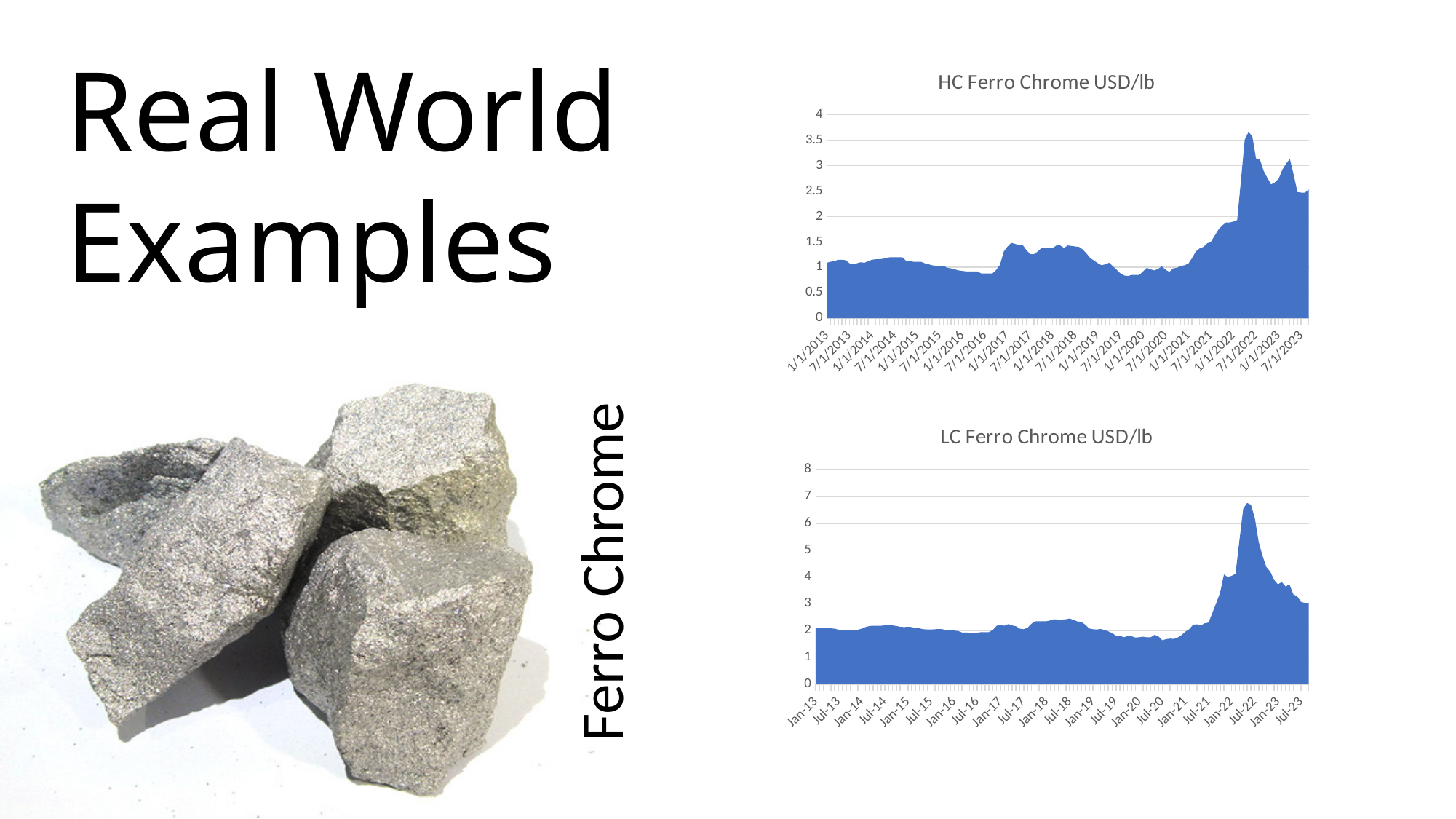
What is the title of the bottom chart on the slide? LC Ferro Chrome USD/lb What is the title of the top chart on the slide? HC Ferro Chrome USD/lb In which year does the LC Ferro Chrome USD/lb chart reach its highest value? 2022 In the HC Ferro Chrome USD/lb chart, is the peak value in 2022 greater or less than 3? greater What kind of chart is the HC Ferro Chrome USD/lb chart? area chart In the LC Ferro Chrome USD/lb chart, do values rise or fall from Jul-22 to Jul-23? fall In which year does the HC Ferro Chrome USD/lb chart reach its highest value? 2022 In the LC Ferro Chrome USD/lb chart, is the value at Jul-23 greater or less than 2? greater In the LC Ferro Chrome USD/lb chart, is the peak value in 2022 greater or less than 6? greater